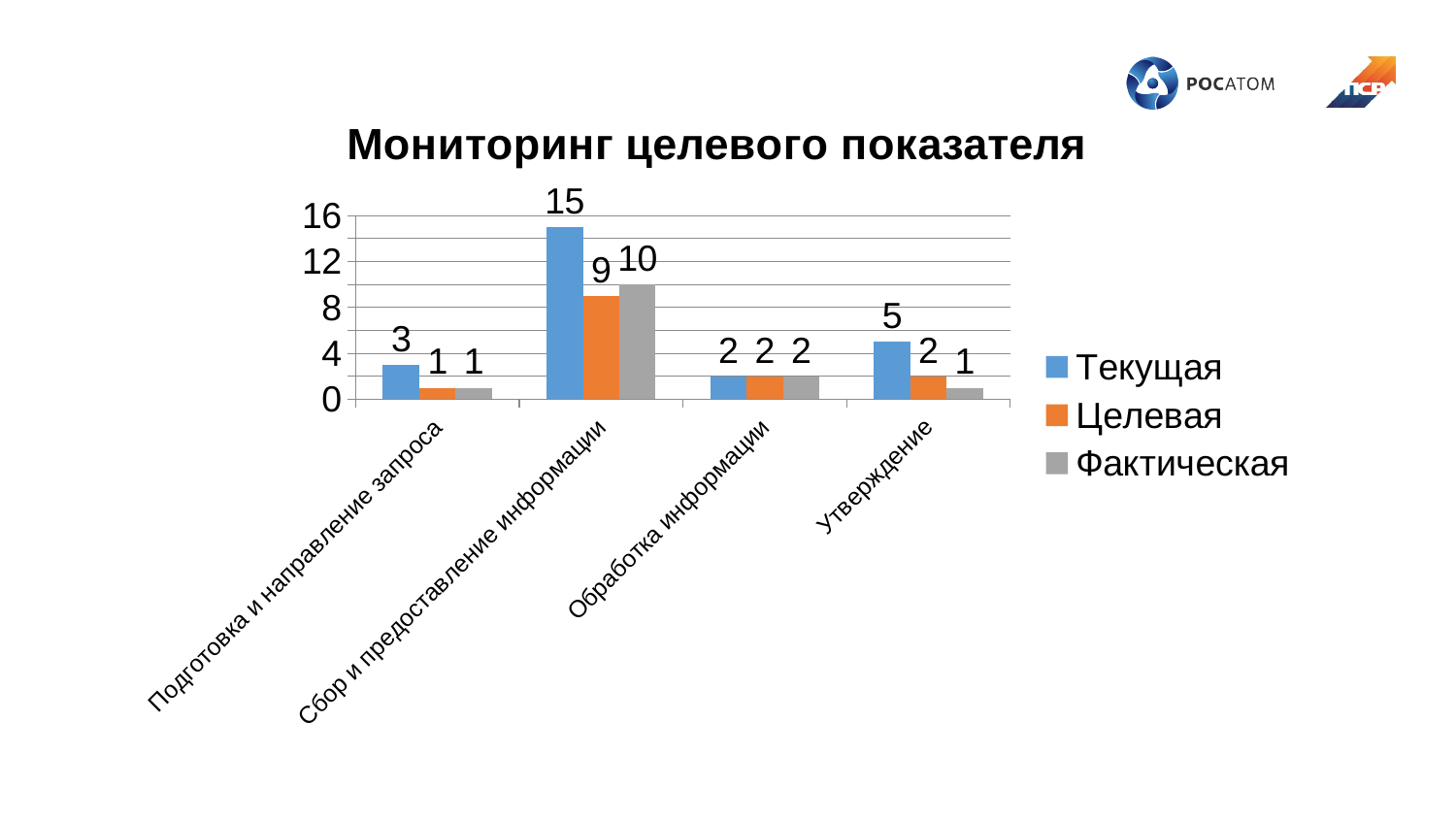
What is the difference between the Текущая and Целевая values for Сбор и предоставление информации? 6 Which category has the highest Текущая value? Сбор и предоставление информации Which is larger for Утверждение: the Текущая value or the Фактическая value? Текущая What is the Целевая value for Утверждение? 2 What is the title of the chart? Мониторинг целевого показателя What is the Текущая value for Сбор и предоставление информации? 15 Which category has the lowest Целевая value? Подготовка и направление запроса What is the Фактическая value for Сбор и предоставление информации? 10 What kind of chart is shown on the slide? Bar chart How many series does the legend list? 3 What is the Текущая value for Подготовка и направление запроса? 3 How many categories are shown on the x axis? 4